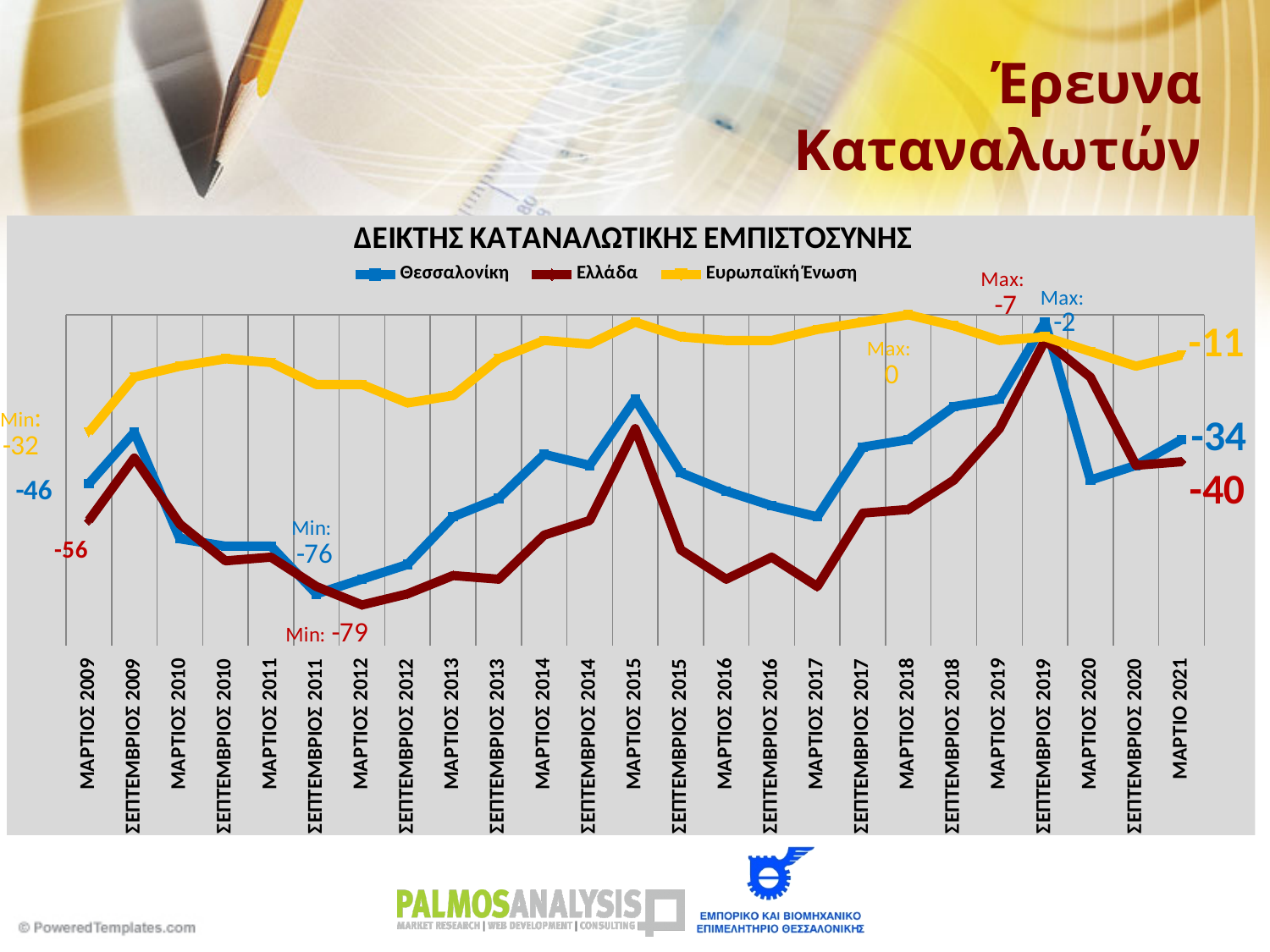
What is the value for Ευρωπαϊκή Ένωση at ΜΑΡΤΙΟ 2021? -11 What is the title of the chart? ΔΕΙΚΤΗΣ ΚΑΤΑΝΑΛΩΤΙΚΗΣ ΕΜΠΙΣΤΟΣΥΝΗΣ What is the value for Ελλάδα at ΜΑΡΤΙΟΣ 2009? -56 What is the value for Ελλάδα at ΜΑΡΤΙΟ 2021? -40 What is the value for Θεσσαλονίκη at ΜΑΡΤΙΟ 2021? -34 What is the maximum value of the Θεσσαλονίκη series, as labelled on the chart? -2 What is the maximum value of the Ευρωπαϊκή Ένωση series, as labelled on the chart? 0 How many series does the legend of the chart list? 3 At ΜΑΡΤΙΟΣ 2009, which series has the higher value: Θεσσαλονίκη or Ελλάδα? Θεσσαλονίκη What is the minimum value of the Ελλάδα series, as labelled on the chart? -79 What is the difference between the Θεσσαλονίκη and Ελλάδα values at ΜΑΡΤΙΟ 2021? 6 What kind of chart is shown on the slide? Line chart